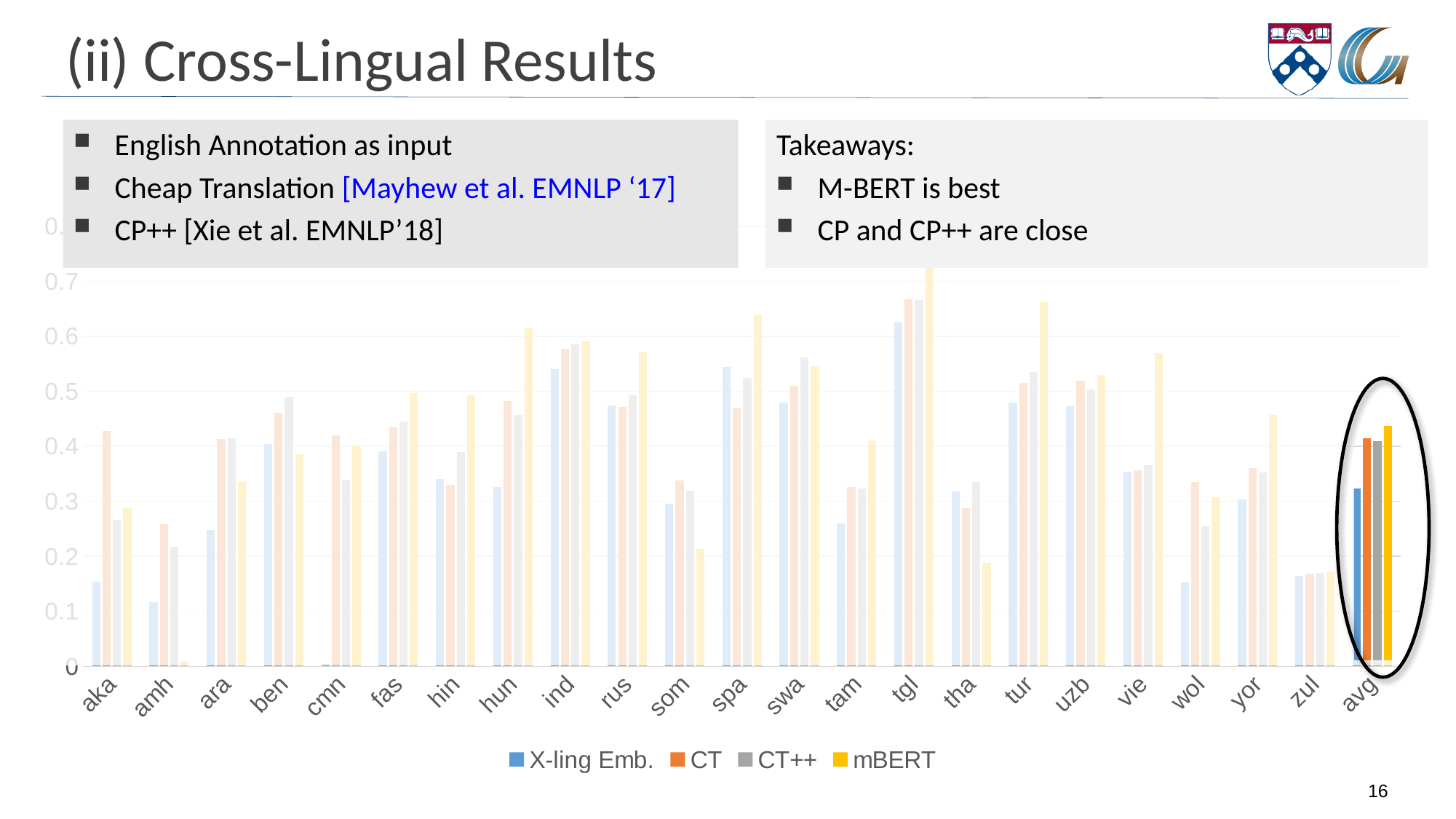
What is the label of the last category on the x axis, which is circled on the slide? avg What kind of chart is shown on the slide? bar chart Is the X-ling Emb. value for avg greater or less than 0.3? greater Which series is shown in yellow in the chart legend? mBERT For the avg category, which series has the larger value: mBERT or X-ling Emb.? mBERT Is the mBERT value for amh greater or less than 0.1? less Is the X-ling Emb. value for zul greater or less than 0.2? less How many series does the chart legend list? 4 Which language has the lowest mBERT value? amh Which language has the highest mBERT value? tgl How many categories are shown along the x axis of the chart? 23